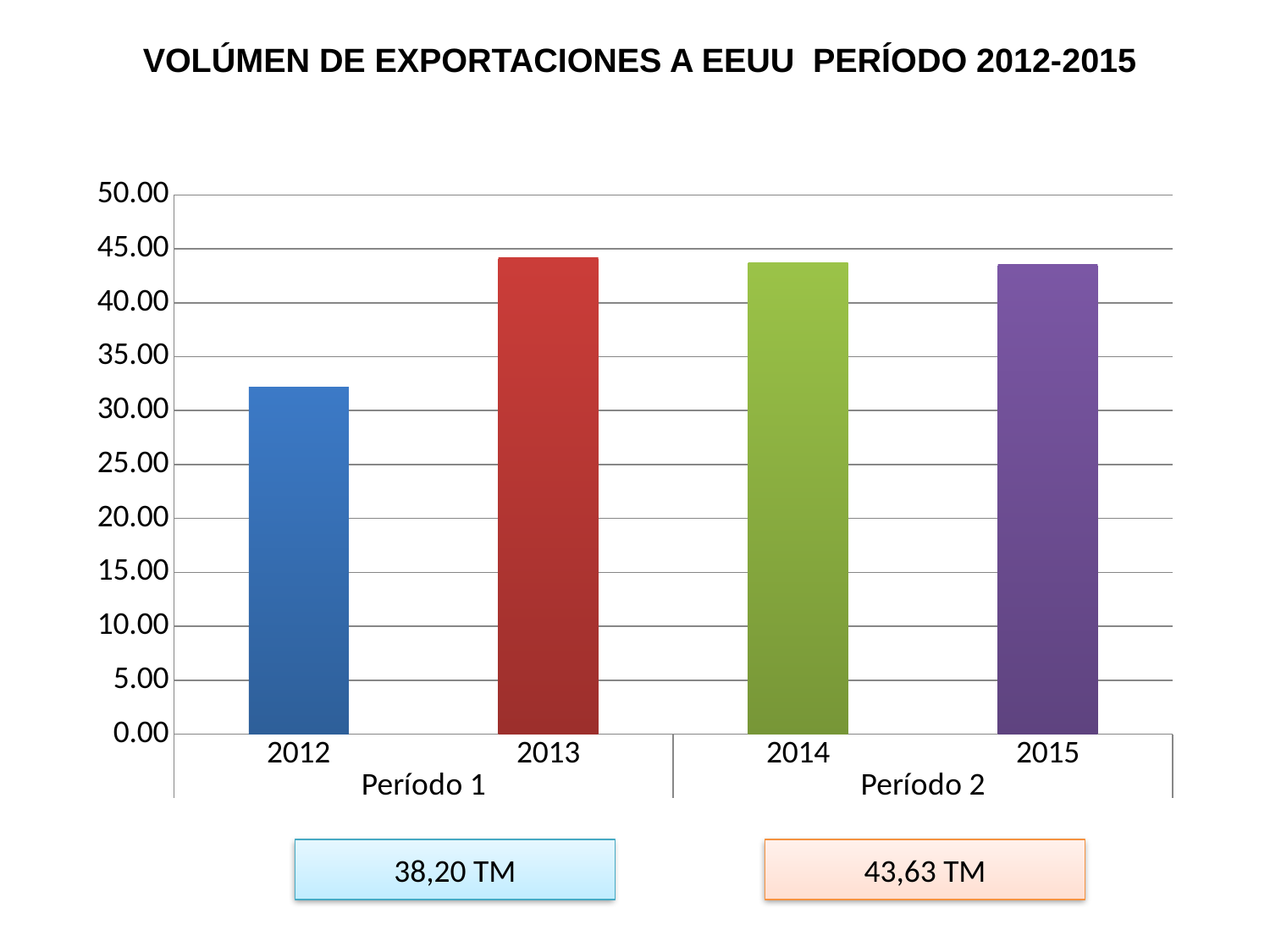
What is the title of the chart? VOLÚMEN DE EXPORTACIONES A EEUU PERÍODO 2012-2015 Which is larger, the value for 2012 or the value for 2013? 2013 Which years belong to the group labelled Período 2 on the x axis? 2014 and 2015 What kind of chart is shown on the slide? bar chart Is the value for 2012 greater or less than 30? greater How many bars are plotted in the chart? 4 Is the value for 2014 greater or less than 40? greater Is the value for 2013 greater or less than 40? greater Does the value rise or fall from 2012 to 2013? rise Which year has the lowest bar in the chart? 2012